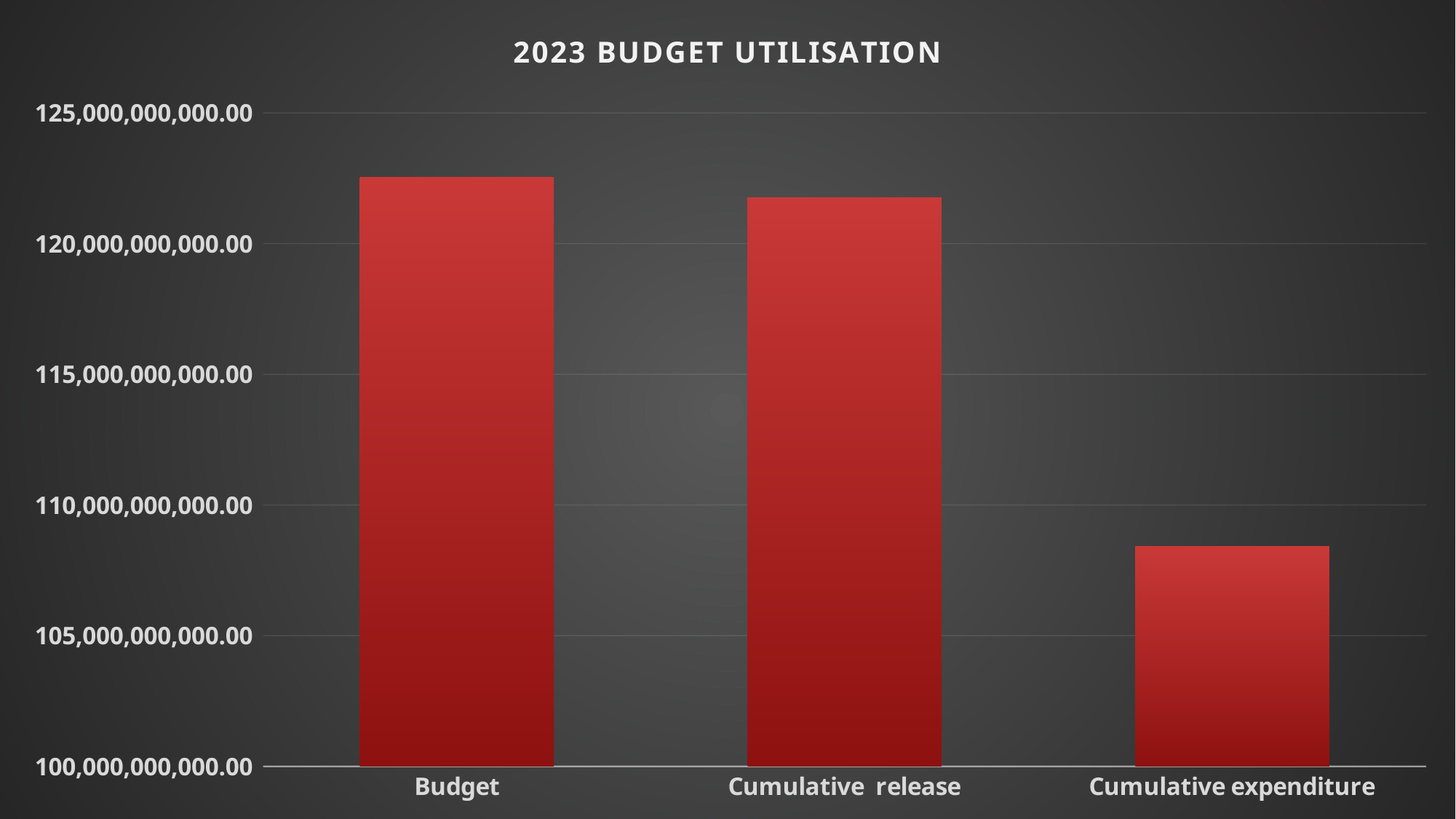
What kind of chart is shown on the slide? bar chart Which is larger, the value for Budget or the value for Cumulative expenditure? Budget Is the value for Cumulative expenditure greater or less than 105,000,000,000.00? greater Which category has the lowest value? Cumulative expenditure Which is larger, the value for Cumulative release or the value for Cumulative expenditure? Cumulative release Do the values rise or fall moving from left to right across the categories? fall Is the value for Cumulative expenditure greater or less than 110,000,000,000.00? less What is the title of the chart? 2023 BUDGET UTILISATION How many categories are plotted in the chart? 3 Which category has the highest value? Budget Is the value for Cumulative release greater or less than 120,000,000,000.00? greater